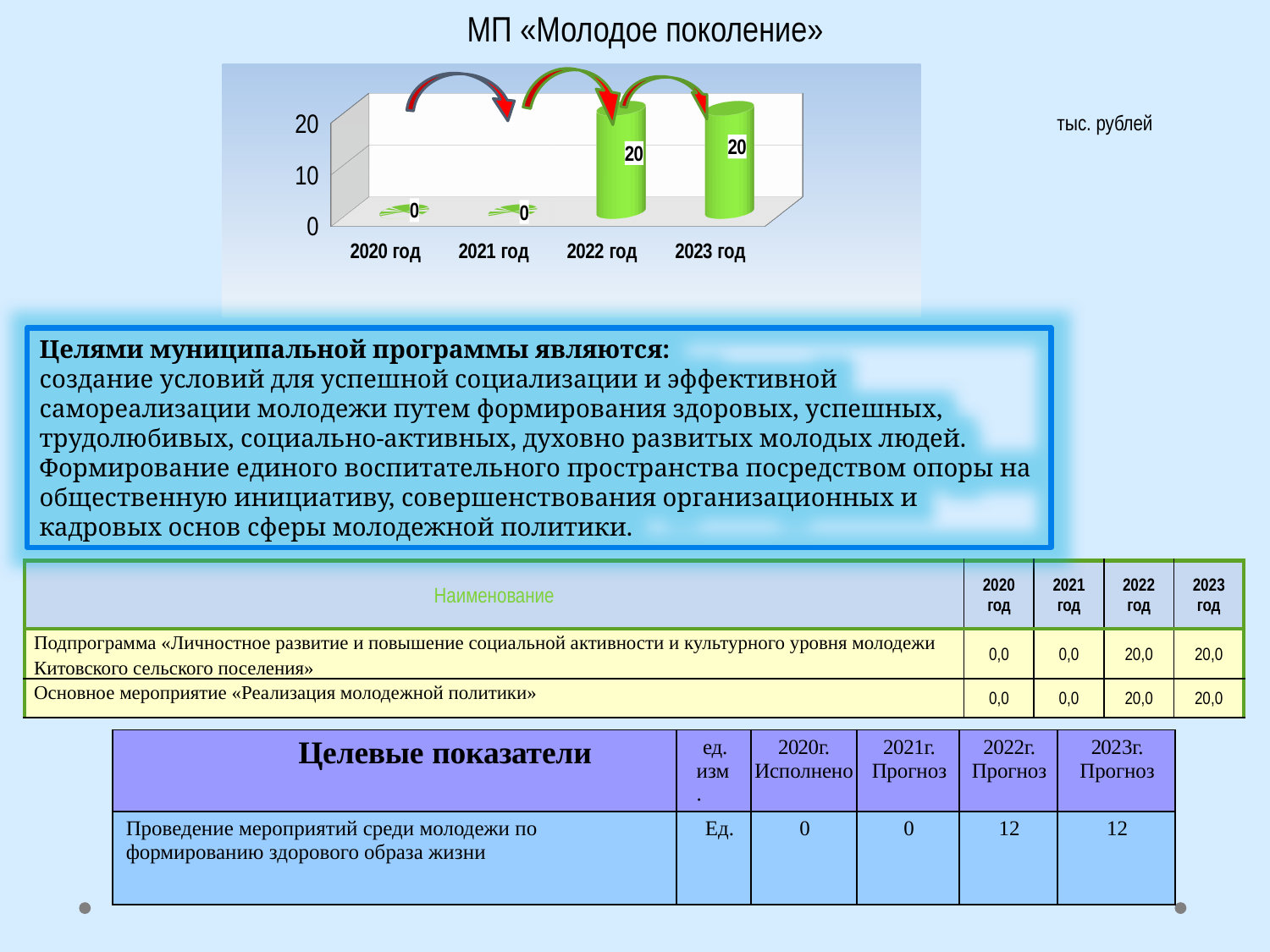
What unit is indicated next to the chart? тыс. рублей What is the difference between the values for 2022 год and 2021 год in the chart? 20 Which is larger in the chart, the value for 2020 год or the value for 2023 год? 2023 год What is the value for 2021 год in the chart? 0 How many categories are shown on the x axis of the chart? 4 Which category has the lowest value in the chart, 2021 год or 2022 год? 2021 год Is the value for 2023 год in the chart greater or less than 10? greater What kind of chart is shown on the slide? bar chart What is the value for 2020 год in the chart? 0 What is the value for 2023 год in the chart? 20 What is the value for 2022 год in the chart? 20 Do the values in the chart rise or fall from 2020 год to 2023 год? rise